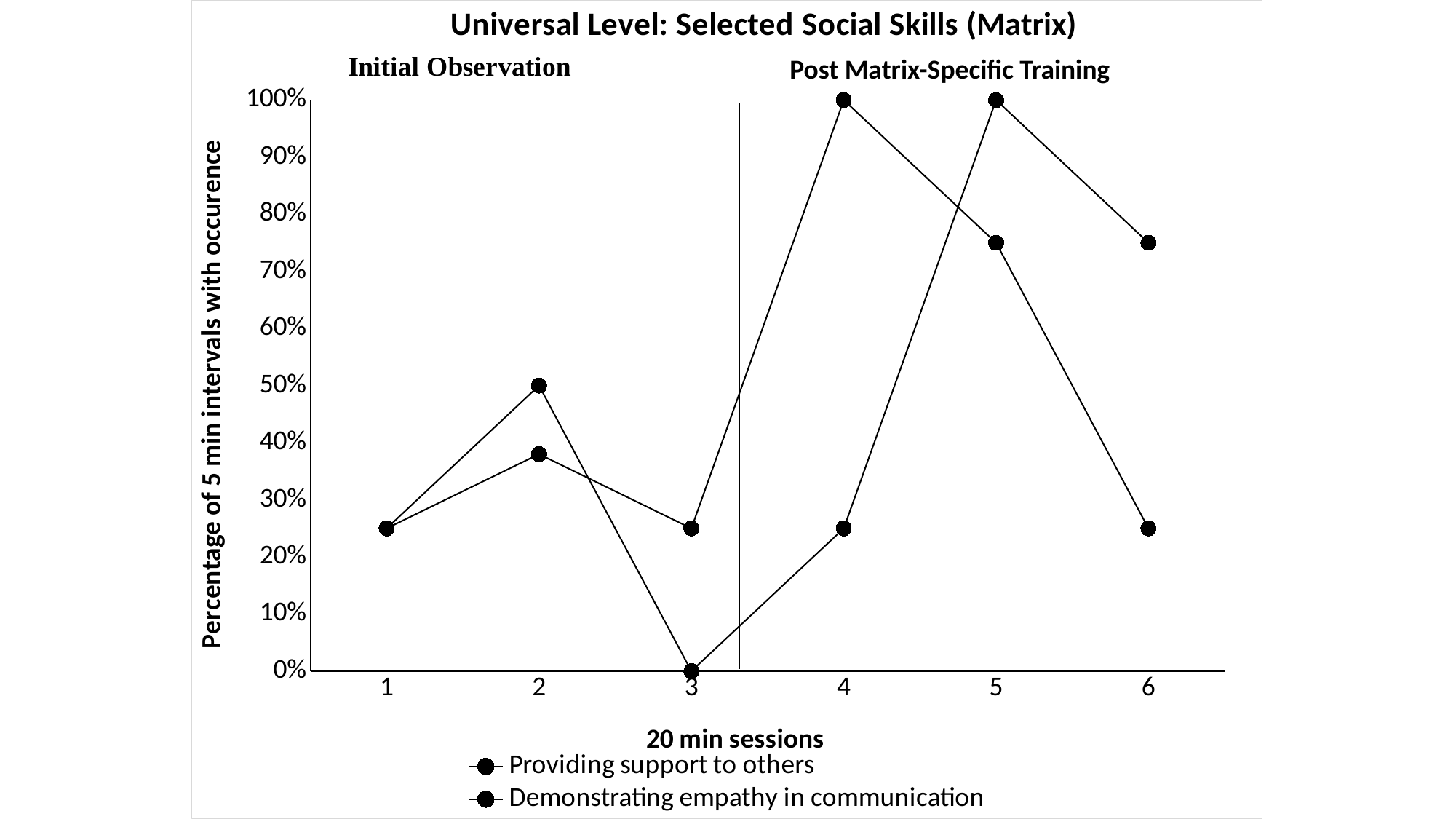
What are the two series named in the legend? Providing support to others; Demonstrating empathy in communication What is the lowest value plotted at session 3? 0% Is the lower of the two values at session 4 greater or less than 40%? less At which session does the lowest value on the chart (0%) occur? 3 Is the higher of the two values at session 6 greater or less than 60%? greater What is the highest value plotted at session 4? 100% What kind of chart is shown on the slide? line chart How many sessions are plotted along the x axis? 6 What is the higher of the two values plotted at session 2? 50% What is the highest value plotted anywhere on the chart? 100% How many series does the legend list? 2 What is the title of the chart? Universal Level: Selected Social Skills (Matrix)